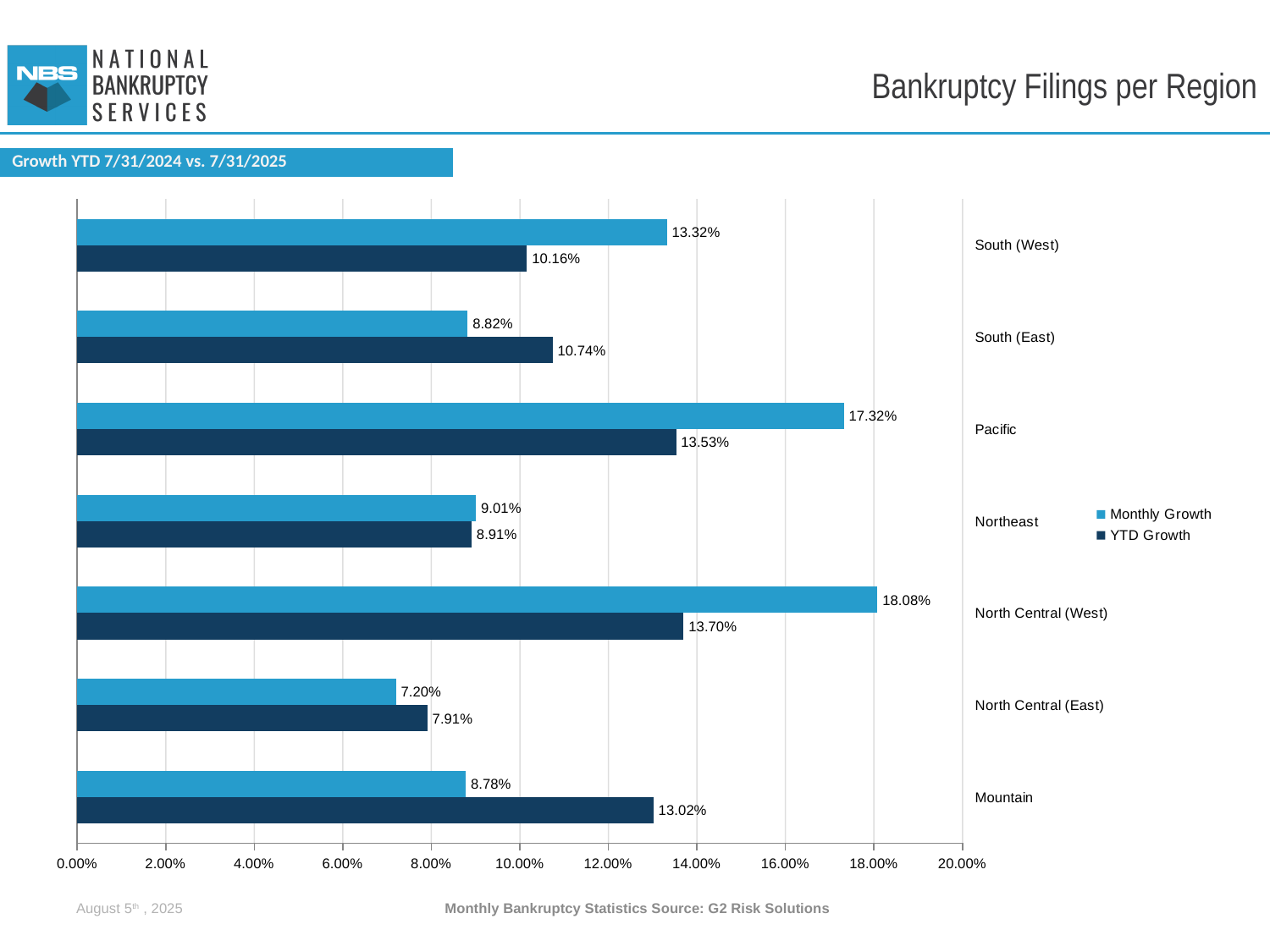
Which region has the highest Monthly Growth? North Central (West) What is the difference between the Monthly Growth of North Central (West) and Pacific? 0.76% How many regions are shown in the chart? 7 What is the difference between Monthly Growth and YTD Growth for South (West)? 3.16% How many series does the legend list? 2 Which region has the lowest YTD Growth? North Central (East) What is the YTD Growth value for Mountain? 13.02% What is the Monthly Growth value for Pacific? 17.32% Which region has the lowest Monthly Growth? North Central (East) For Mountain, which is larger: Monthly Growth or YTD Growth? YTD Growth What is the YTD Growth value for South (East)? 10.74% What kind of chart is shown on the slide? Bar chart